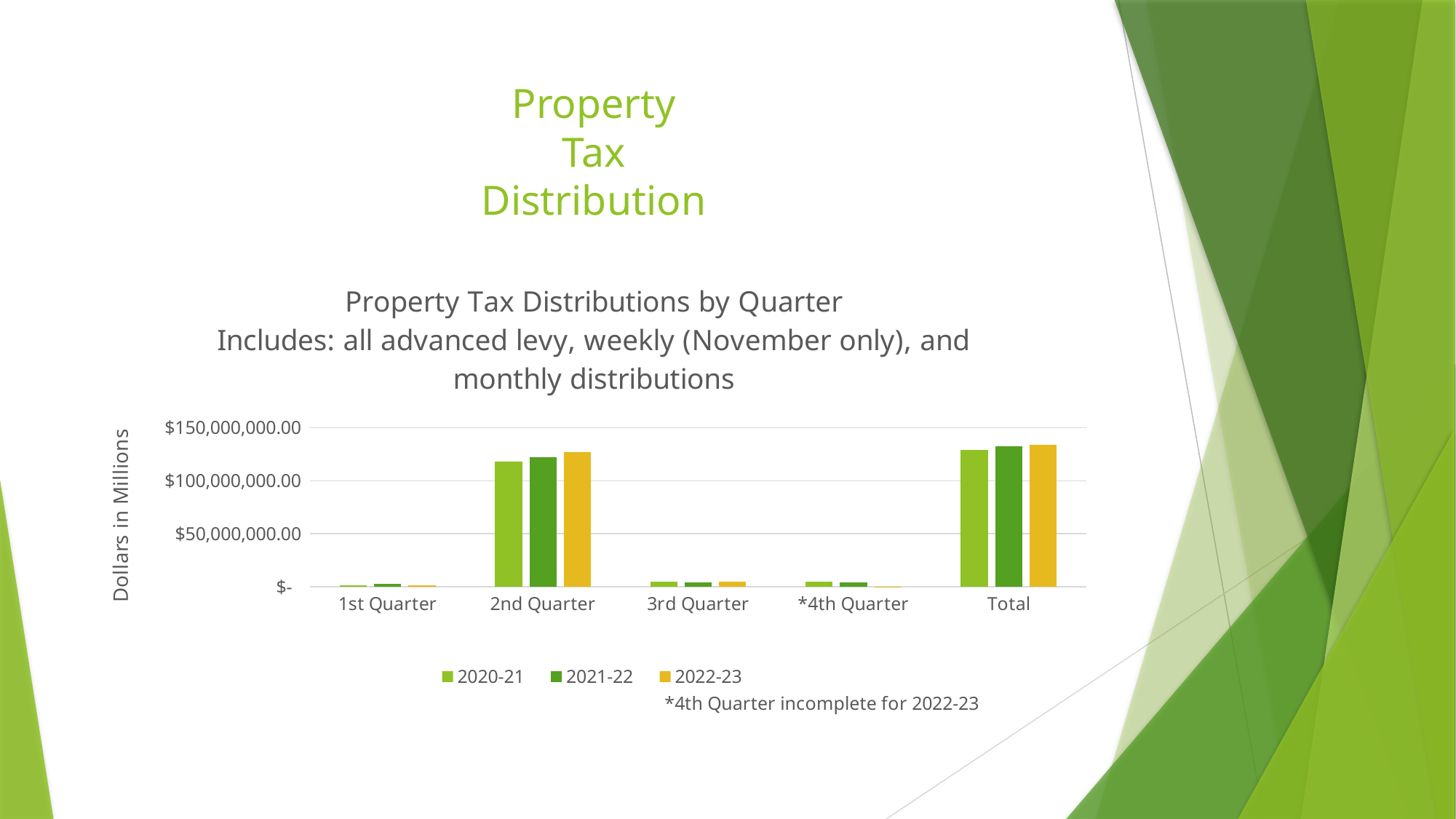
What kind of chart is shown on the slide? Bar chart Which series are listed in the chart's legend? 2020-21, 2021-22, 2022-23 Among the four quarters, which quarter has the lowest value for the 2020-21 series? 1st Quarter Is the value for 1st Quarter in the 2021-22 series greater or less than $50,000,000.00? less How many series does the chart's legend list? 3 How many categories are shown along the x axis of the chart? 5 For the 2022-23 series, which is larger: the value for 2nd Quarter or the value for 3rd Quarter? 2nd Quarter Is the value for 3rd Quarter in the 2022-23 series greater or less than $50,000,000.00? less What is the label on the vertical axis of the chart? Dollars in Millions Is the value for Total in the 2022-23 series greater or less than $150,000,000.00? less Among the four quarters, which quarter has the highest value for the 2021-22 series? 2nd Quarter